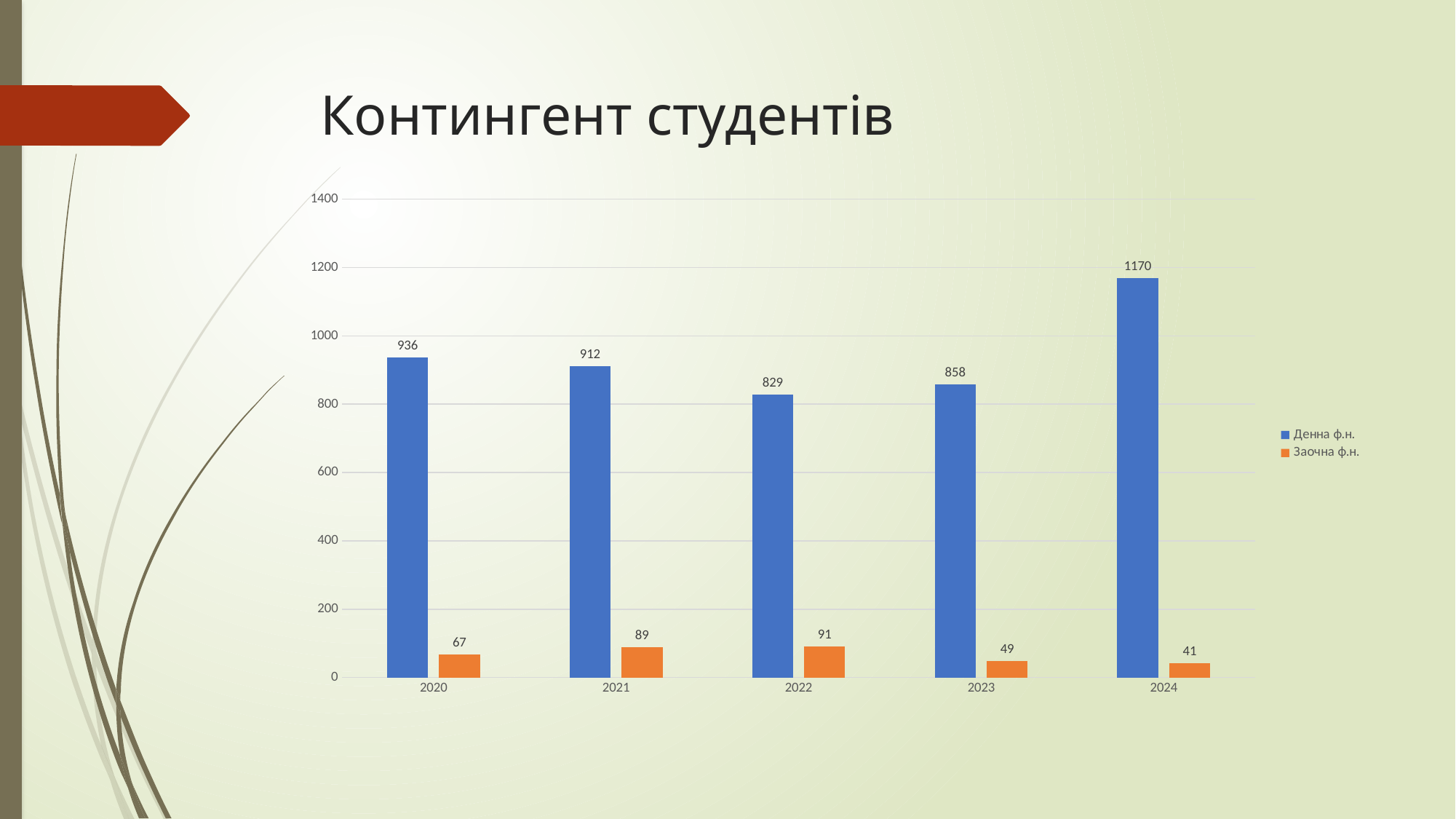
What is the value for Денна ф.н. in 2024? 1170 How many years are shown on the x axis? 5 What is the value for Денна ф.н. in 2022? 829 Which is larger, the Заочна ф.н. value for 2021 or for 2023? 2021 What kind of chart is shown on the slide? bar chart What is the difference between the Денна ф.н. values for 2024 and 2023? 312 What is the value for Заочна ф.н. in 2022? 91 Which year has the lowest value for Заочна ф.н.? 2024 Which year has the highest value for Денна ф.н.? 2024 What is the title of the chart on the slide? Контингент студентів How many series does the legend list? 2 Is the value for Денна ф.н. in 2020 greater or less than 800? greater